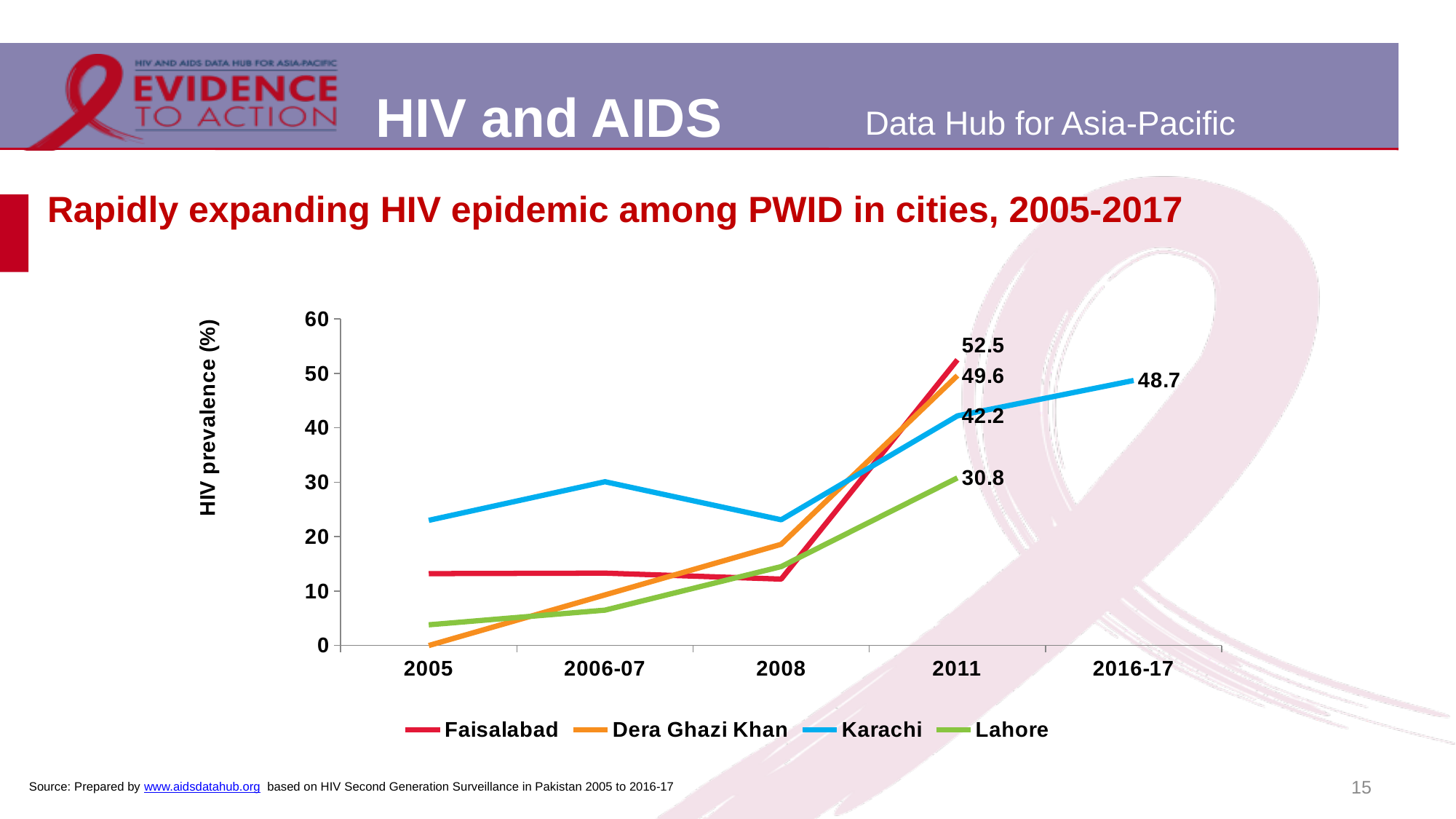
What is the HIV prevalence for Faisalabad in 2011? 52.5 What is the HIV prevalence for Lahore in 2011? 30.8 How many cities does the legend list? 4 Which city has the highest HIV prevalence in 2011? Faisalabad Which city has the lowest HIV prevalence in 2011? Lahore Is the HIV prevalence for Karachi in 2005 greater or less than 20? greater What is the HIV prevalence for Karachi in 2016-17? 48.7 Does the HIV prevalence for Lahore rise or fall from 2005 to 2011? rises What kind of chart is shown on the slide? line chart What is the difference between the 2011 HIV prevalence for Faisalabad and Lahore? 21.7 In 2011, which city has the higher HIV prevalence, Karachi or Dera Ghazi Khan? Dera Ghazi Khan What is the HIV prevalence for Dera Ghazi Khan in 2011? 49.6